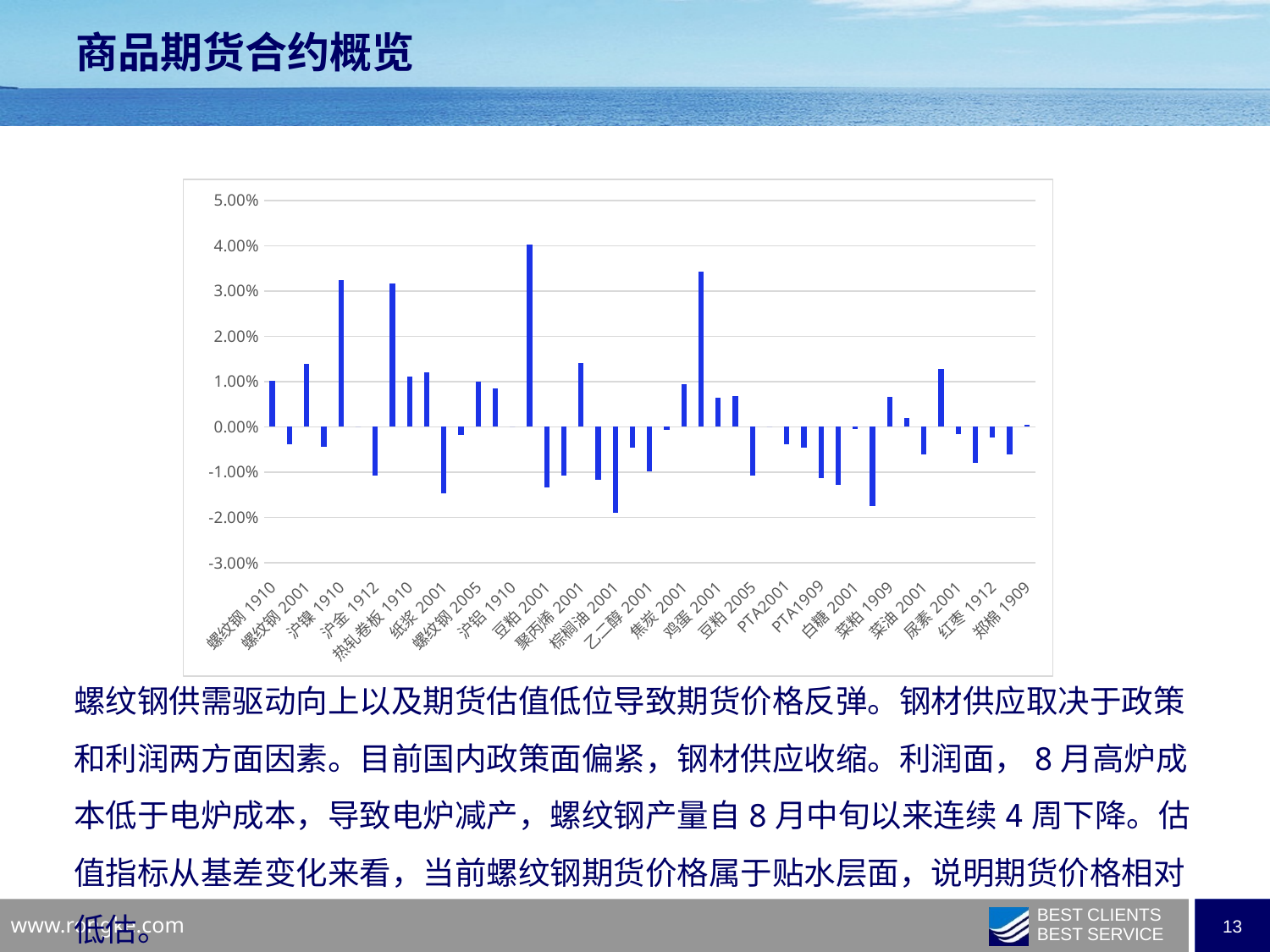
How many category labels are printed along the x axis of the chart? 23 What kind of chart is shown on the slide? bar chart Is the value of the lowest bar in the chart greater or less than -1.00%? less Is the value of the lowest bar in the chart greater or less than -2.00%? greater What is the highest tick value shown on the y axis of the chart? 5.00% Is the value for 螺纹钢 1910 greater or less than 0.00%? greater What is the lowest tick value shown on the y axis of the chart? -3.00%